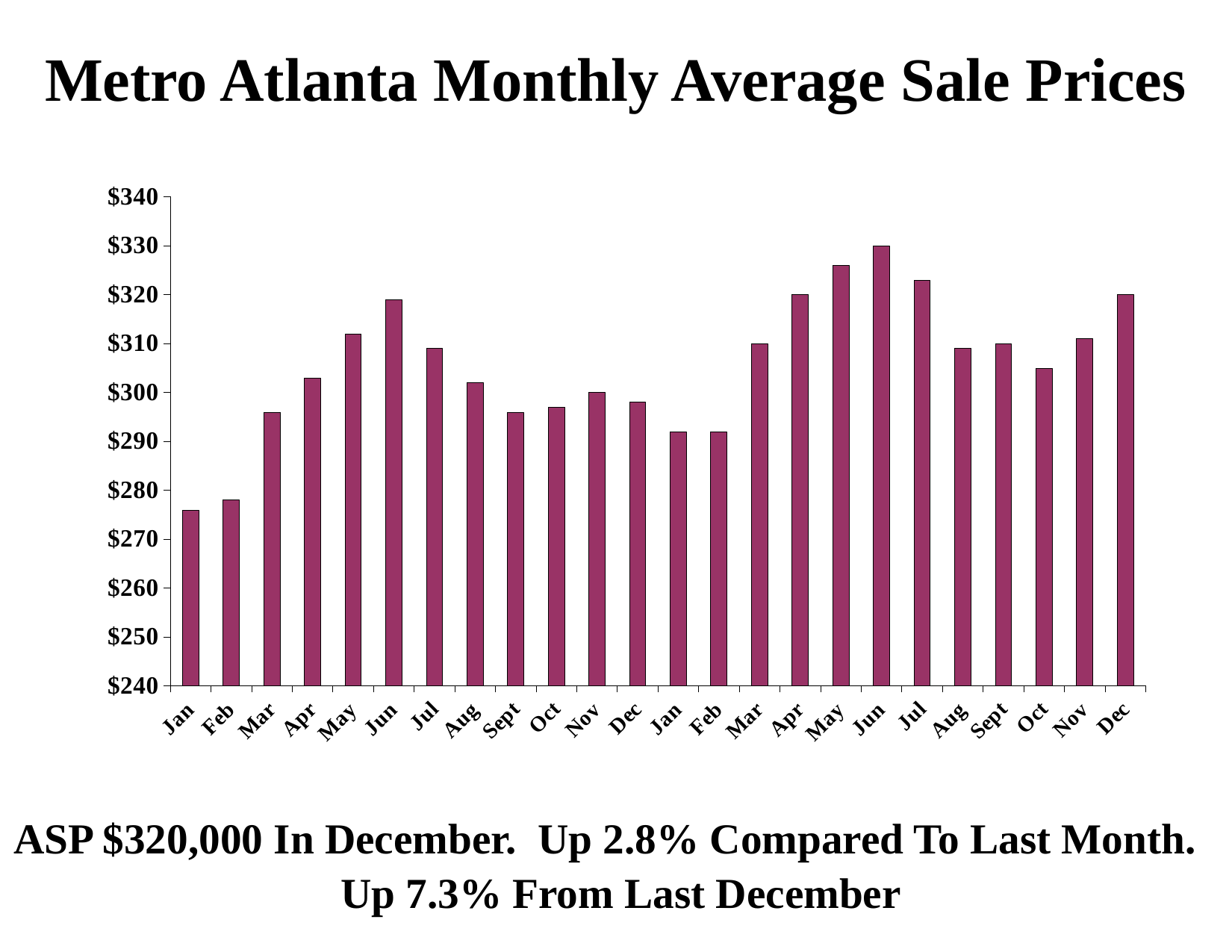
Which is larger, the first-year Jun bar or the second-year Jun bar? second-year Jun What is the title of the chart? Metro Atlanta Monthly Average Sale Prices Which month has the lowest average sale price in the chart? Jan (first year) Is the value for the second-year Oct bar greater or less than $300? greater Is the value for the second-year Jun bar greater or less than $320? greater What kind of chart is shown on the slide? bar chart Do the values rise or fall from Jan to Jun in the first year? rise Which month has the highest average sale price in the chart? Jun (second year) How many bars (months) are plotted in the chart? 24 Is the value for the first-year Sept bar greater or less than $300? less According to the text below the chart, what was the ASP in December? $320,000